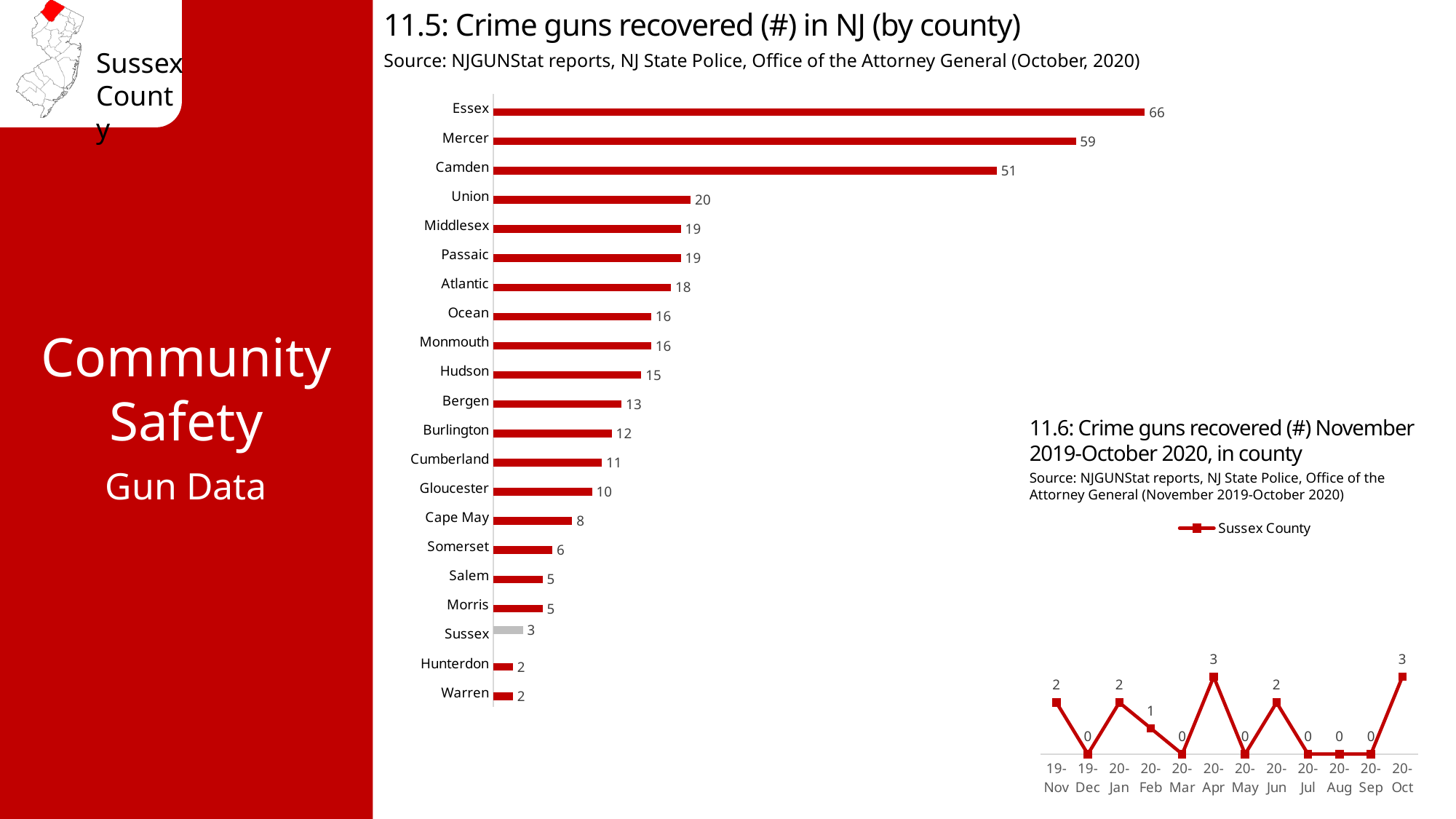
In chart 11.6 (Crime guns recovered November 2019-October 2020, in county), what is the difference between the value for 20-Oct and the value for 20-Sep? 3 In chart 11.5 (Crime guns recovered in NJ by county), what is the value for Sussex? 3 In chart 11.5 (Crime guns recovered in NJ by county), how many counties are listed? 21 What kind of chart is chart 11.5 (Crime guns recovered in NJ by county)? Bar chart In chart 11.5 (Crime guns recovered in NJ by county), what is the difference between Mercer and Camden? 8 In chart 11.6 (Crime guns recovered November 2019-October 2020, in county), what is the value for 20-Apr? 3 In chart 11.5 (Crime guns recovered in NJ by county), which is larger, the value for Union or the value for Hudson? Union In chart 11.6 (Crime guns recovered November 2019-October 2020, in county), how many series does the legend list? 1 In chart 11.6 (Crime guns recovered November 2019-October 2020, in county), how many months are plotted? 12 In chart 11.5 (Crime guns recovered in NJ by county), which county's bar is shown in grey rather than red? Sussex In chart 11.5 (Crime guns recovered in NJ by county), how many crime guns were recovered in Essex? 66 In chart 11.5 (Crime guns recovered in NJ by county), which county has the highest number of crime guns recovered? Essex